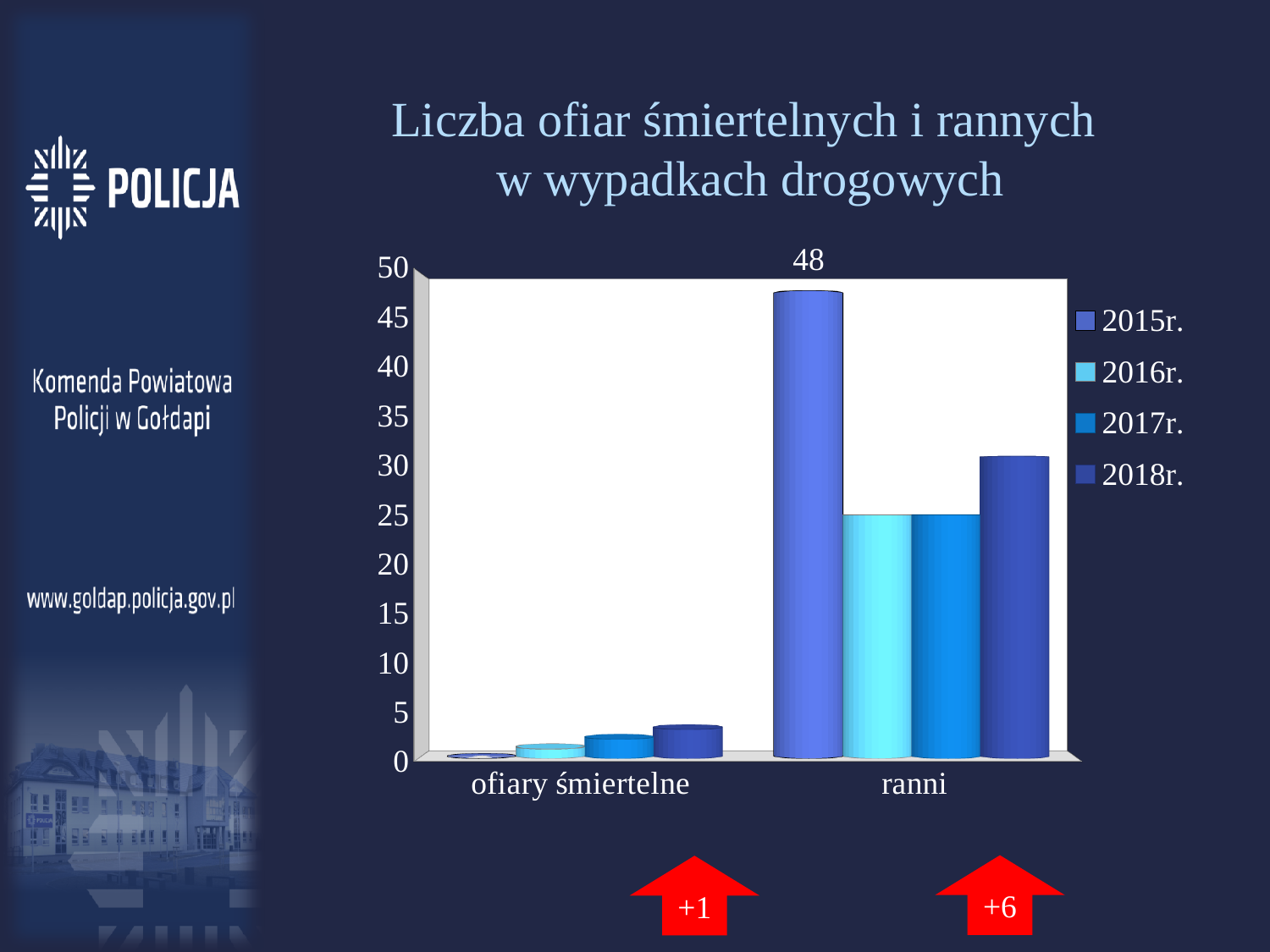
What is the value for 2015r. in the "ranni" category? 48 Which year has the highest value in the "ranni" category? 2015r. What is the title of the chart? Liczba ofiar śmiertelnych i rannych w wypadkach drogowych Is the value for 2018r. in the "ranni" category greater or less than 25? greater How many categories are shown on the x axis? 2 Which is larger in the "ranni" category: the value for 2015r. or the value for 2018r.? 2015r. How many series does the legend list? 4 Which category has the highest bar overall? ranni Is the value for 2018r. in the "ofiary śmiertelne" category greater or less than 5? less What kind of chart is shown on the slide? bar chart Do the values for "ofiary śmiertelne" rise or fall from 2015r. to 2018r.? rise Is the value for 2016r. in the "ranni" category greater or less than 30? less